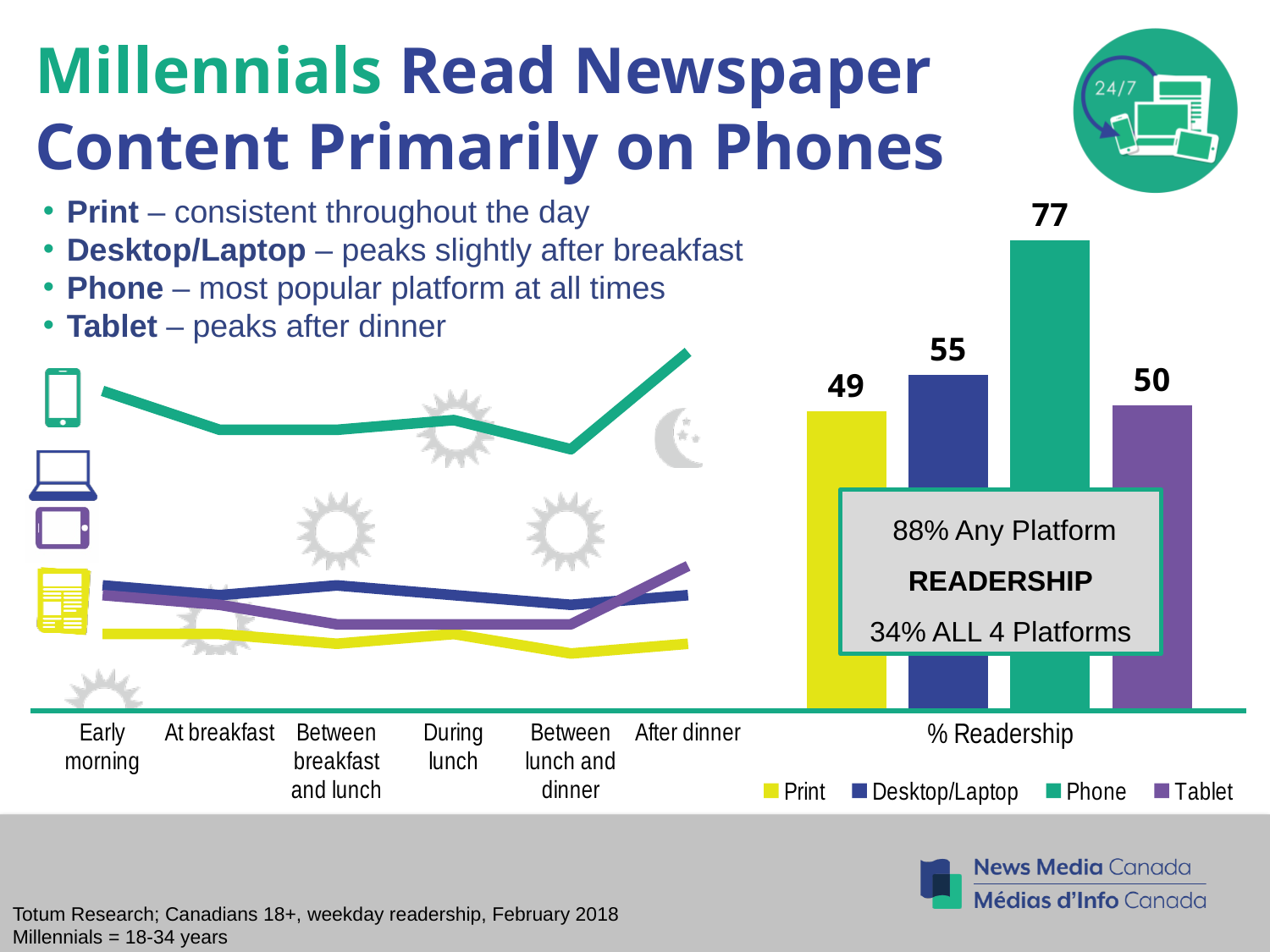
How many time-of-day categories are shown on the x axis of the line chart on the left? 6 In the bar chart on the right, which has a higher % Readership, Desktop/Laptop or Tablet? Desktop/Laptop In the bar chart on the right, which platform has the lowest % Readership? Print In the bar chart on the right, what is the % Readership value for Phone? 77 How many series does the legend below the charts list? 4 How many platforms are shown as bars in the bar chart on the right? 4 In the line chart on the left, which platform's line is highest at every time of day? Phone In the bar chart on the right, what is the % Readership value for Tablet? 50 In the bar chart on the right, what is the difference in % Readership between Phone and Desktop/Laptop? 22 In the bar chart on the right, which platform has the highest % Readership? Phone What kind of chart is the chart on the left showing readership by time of day? Line chart In the bar chart on the right, what is the % Readership value for Print? 49